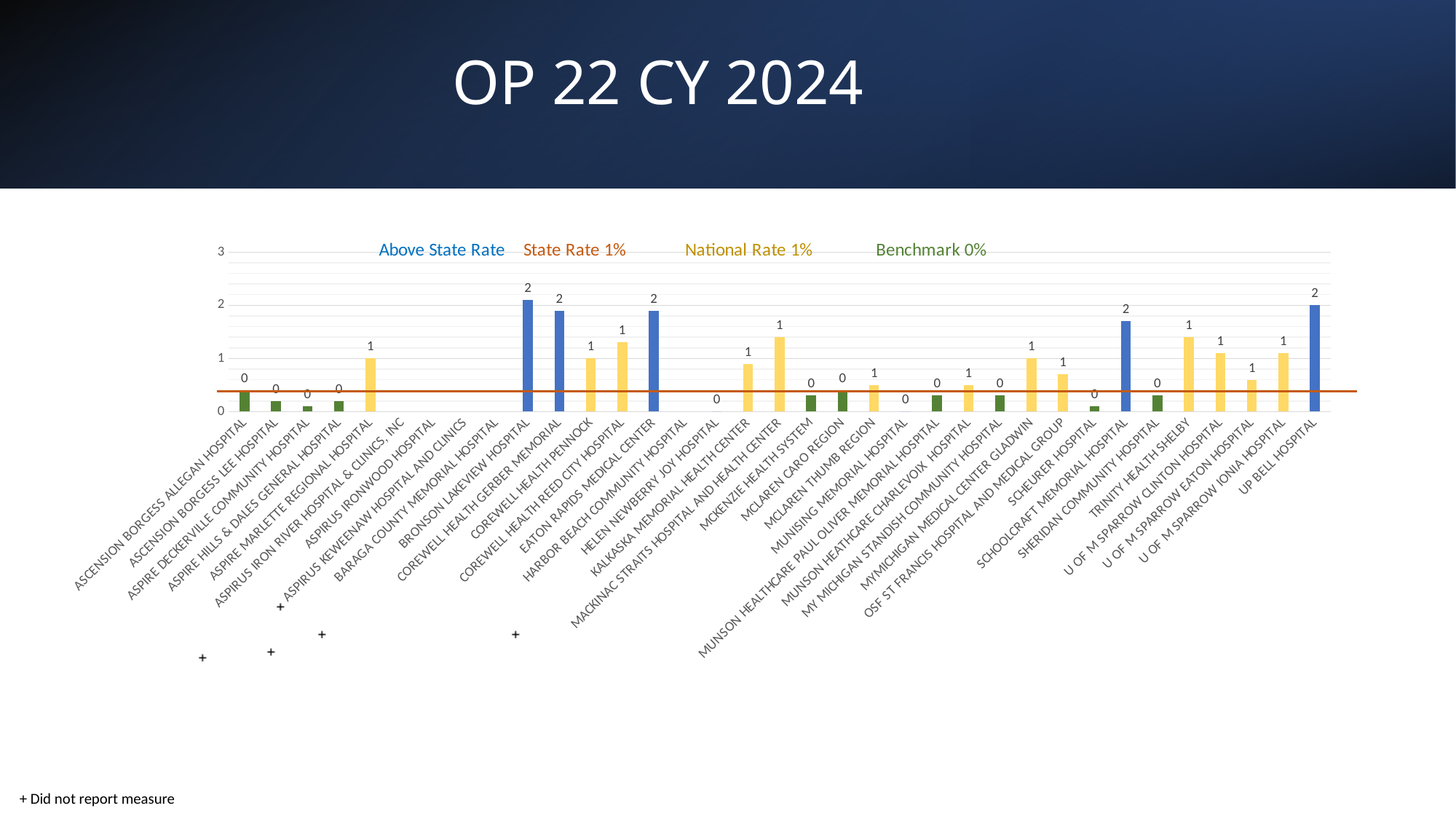
What does the orange horizontal line across the chart represent? State Rate Which has the larger value, Bronson Lakeview Hospital or Corewell Health Pennock? Bronson Lakeview Hospital What kind of chart is shown on the slide? bar chart What is the value shown for UP Bell Hospital? 2 What is the value shown for McKenzie Health System? 0 What is the value shown for Aspire Marlette Regional Hospital? 1 According to the footnote, what does the + symbol next to a hospital indicate? Did not report measure What is the value shown for Eaton Rapids Medical Center? 2 What is the value shown for Bronson Lakeview Hospital? 2 Which has the larger value, Schoolcraft Memorial Hospital or Sheridan Community Hospital? Schoolcraft Memorial Hospital